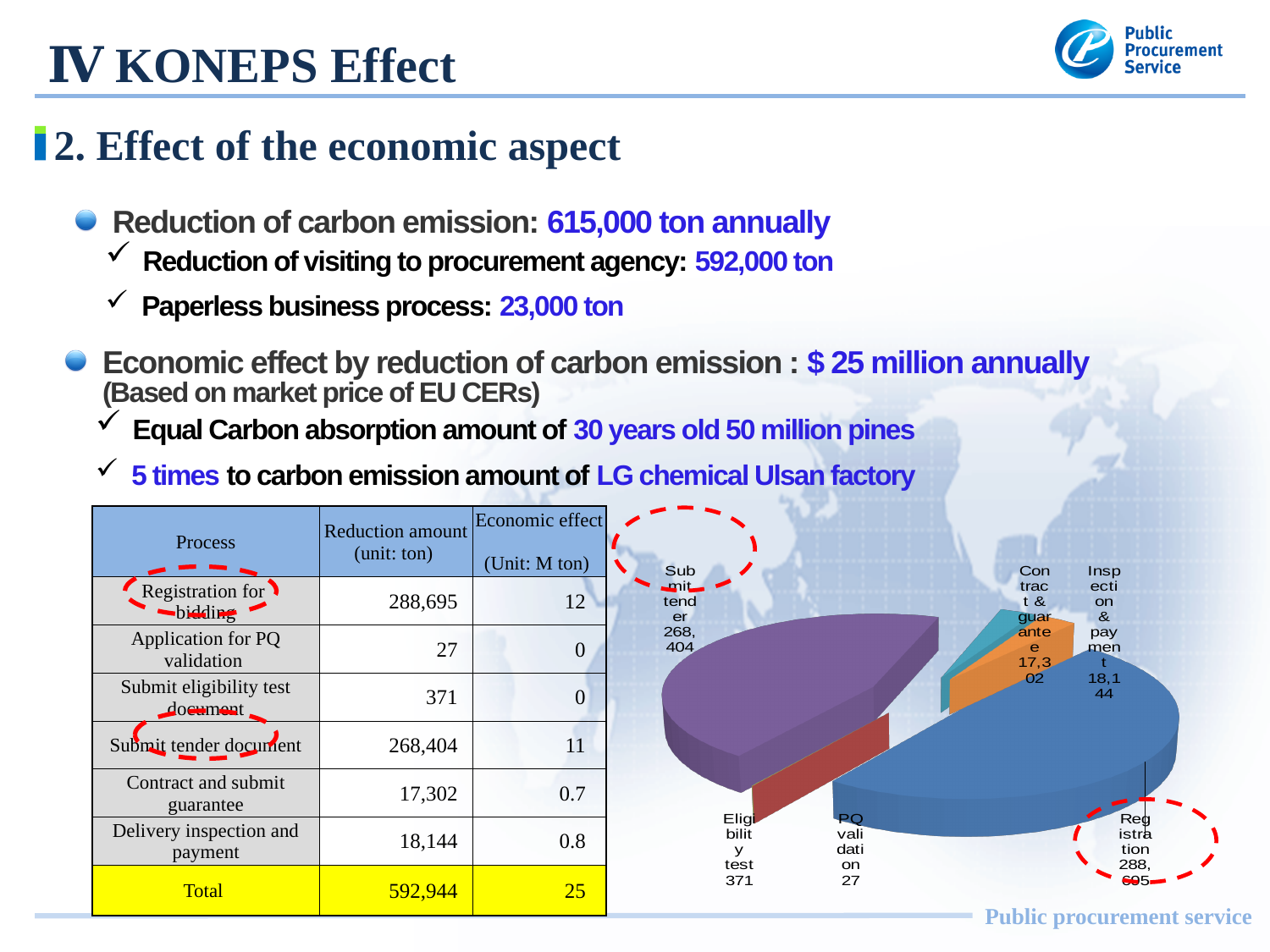
What is the value shown for the Eligibility test slice in the pie chart? 371 Which slice of the pie chart has the smallest value? PQ validation What is the difference between the Inspection & payment and Contract & guarantee values in the pie chart? 842 What is the value shown for the Inspection & payment slice in the pie chart? 18,144 What is the value shown for the PQ validation slice in the pie chart? 27 In the pie chart, which is larger: Inspection & payment or Contract & guarantee? Inspection & payment Which slice of the pie chart has the largest value? Registration What kind of chart is shown on the slide? pie chart What is the difference between the Registration and Submit tender values in the pie chart? 20,291 How many slices does the pie chart have? 6 What is the value shown for the Submit tender slice in the pie chart? 268,404 What is the value shown for the Contract & guarantee slice in the pie chart? 17,302